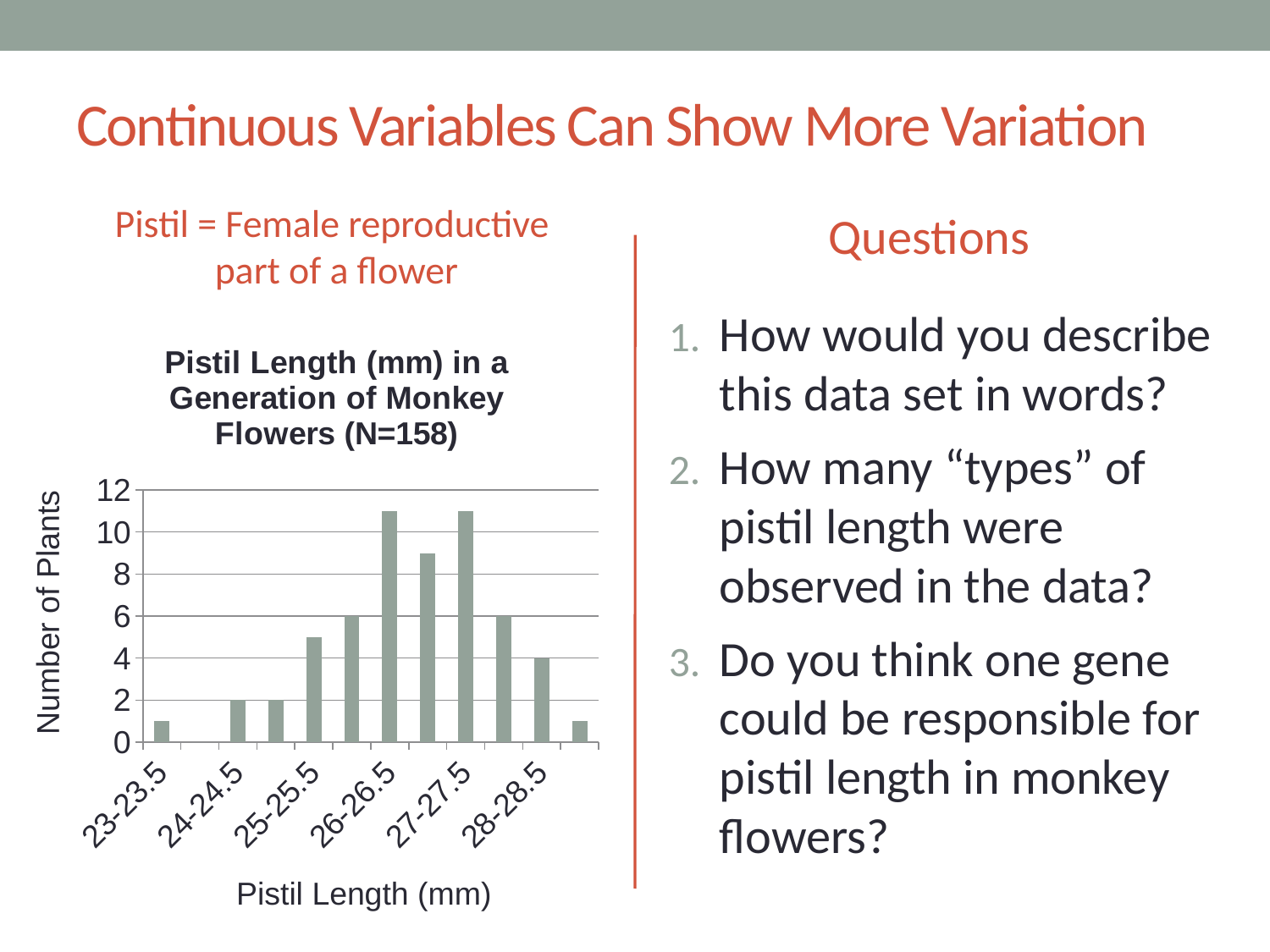
How many plants are in the 28-28.5 mm pistil length category? 4 What is the label of the vertical axis? Number of Plants Is the number of plants for 26-26.5 greater or less than 10? greater What is the difference in number of plants between the 28-28.5 and 24-24.5 categories? 2 Is the number of plants for 23-23.5 greater or less than 2? less How many plants are in the 24-24.5 mm pistil length category? 2 Which has fewer plants, the 23-23.5 category or the 28-28.5 category? 23-23.5 Is the number of plants for 25-25.5 greater or less than 4? greater What is the title of the chart? Pistil Length (mm) in a Generation of Monkey Flowers (N=158) What kind of chart is shown on the slide? bar chart Do the bar heights rise or fall from the 24-24.5 category to the 26-26.5 category? rise Which has more plants, the 26-26.5 category or the 24-24.5 category? 26-26.5